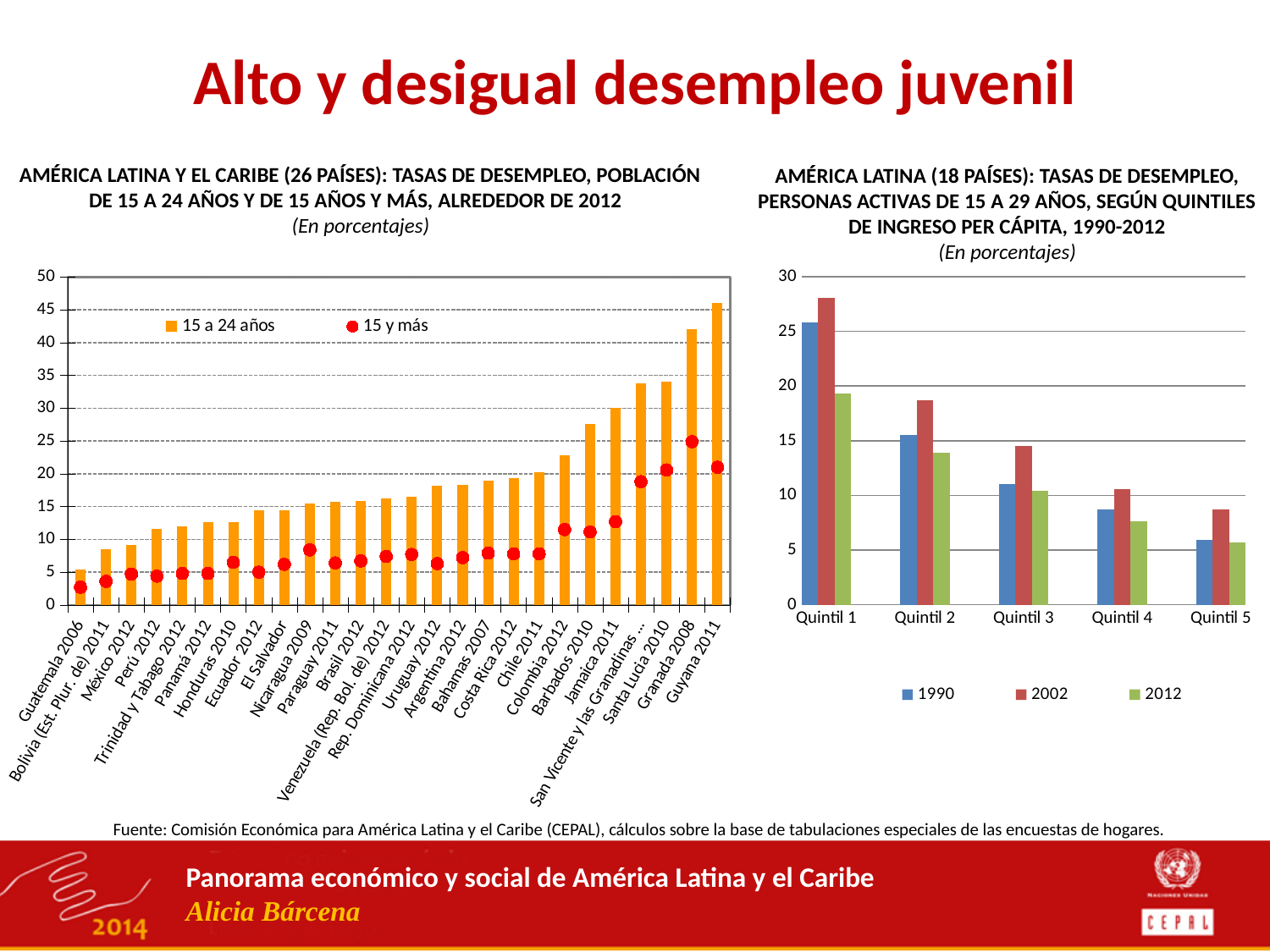
On the left chart, which country has the lowest bar for the 15 a 24 años series? Guatemala 2006 On the left chart, which country has the highest unemployment rate for the 15 a 24 años series? Guyana 2011 On the right chart, is the 2002 value for Quintil 1 greater or less than 25? greater On the left chart, do the 15 a 24 años bars rise or fall from left to right? rise On the right chart, which quintile has the highest unemployment rate for 2002? Quintil 1 What type of chart is the right chart? bar chart On the right chart, for Quintil 1, which is larger: the 2002 value or the 2012 value? 2002 On the right chart, how many series does the legend list? 3 On the right chart, how many quintile categories are shown on the x axis? 5 On the left chart, is the 15 y más value for Granada 2008 greater or less than 20? greater On the left chart, is the 15 a 24 años value for Guyana 2011 greater or less than 40? greater On the left chart, how many series does the legend list? 2